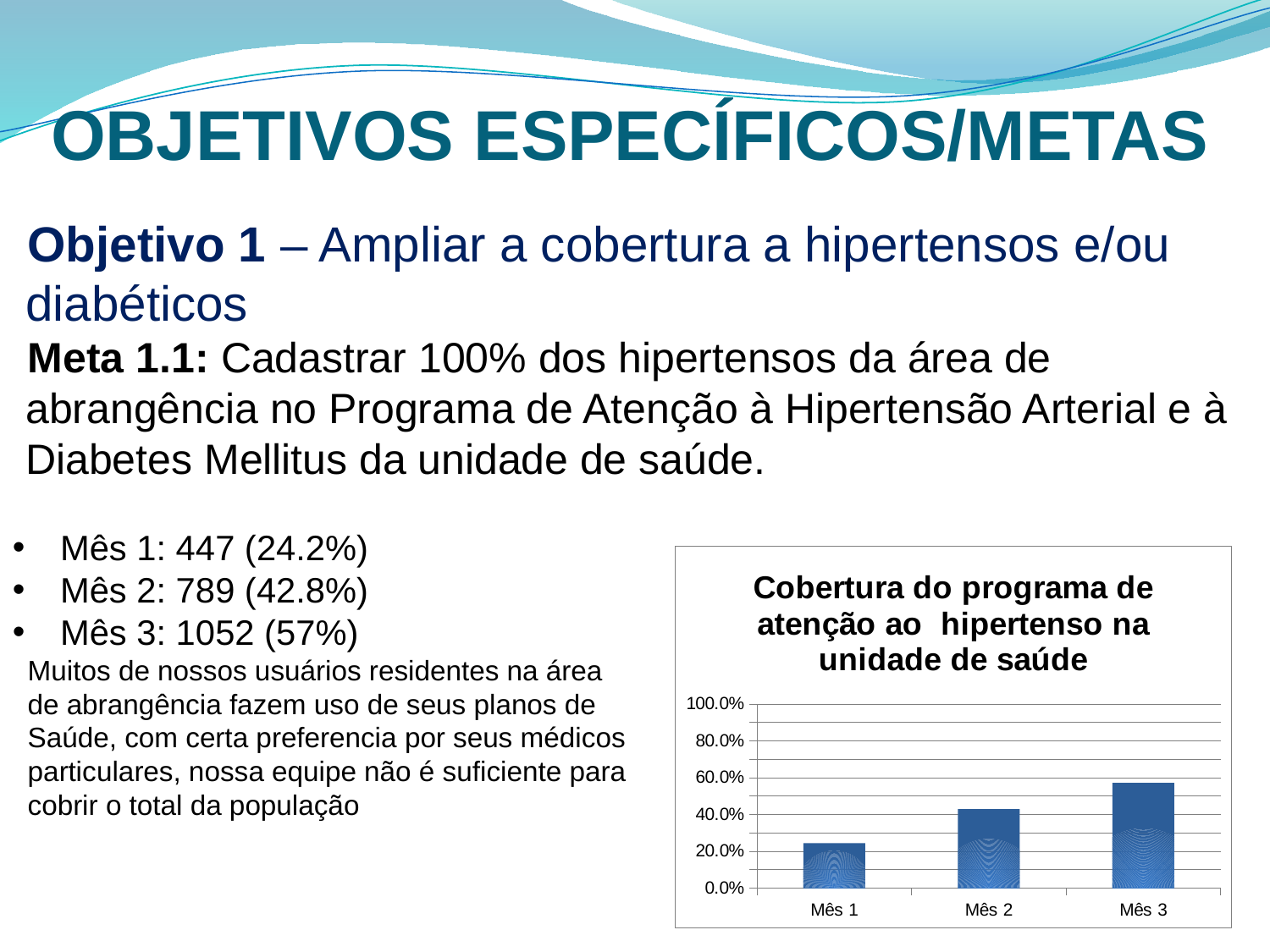
Is the value for Mês 3 greater or less than 60.0%? less Is the value for Mês 2 greater or less than 60.0%? less Is the value for Mês 1 greater or less than 40.0%? less What kind of chart is shown on the slide? bar chart Which is larger, the value for Mês 2 or the value for Mês 1? Mês 2 Do the values rise or fall from Mês 1 to Mês 3? rise How many categories are plotted on the x axis of the chart? 3 Which month has the highest coverage in the chart? Mês 3 What is the title of the chart? Cobertura do programa de atenção ao hipertenso na unidade de saúde Which month has the lowest coverage in the chart? Mês 1